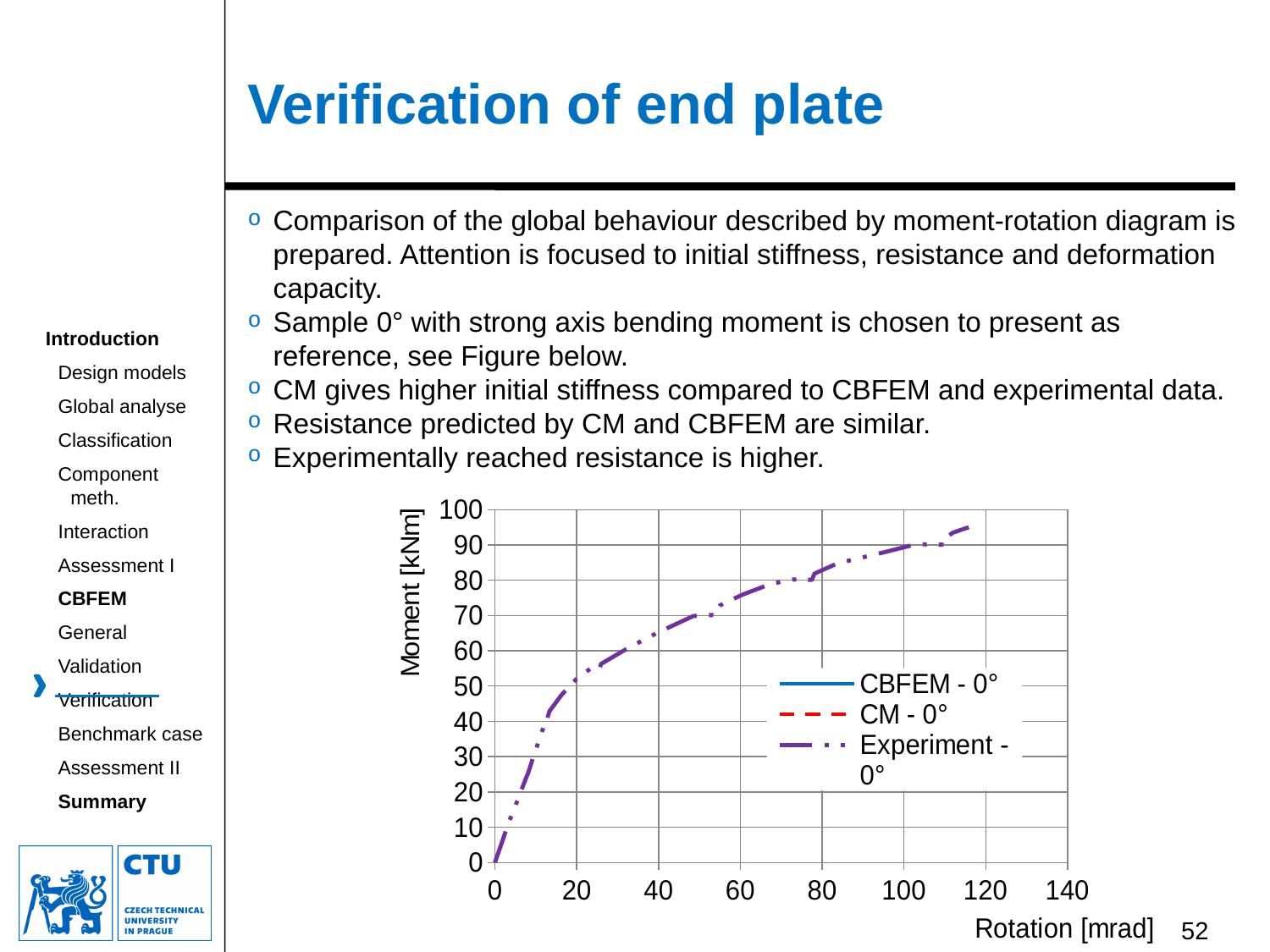
Is the moment of the Experiment - 0° curve at a rotation of 10 mrad greater or less than 50 kNm? less How many series does the chart legend list? 3 What is the label of the x axis of the chart? Rotation [mrad] What is the label of the y axis of the chart? Moment [kNm] Is the largest rotation reached by the Experiment - 0° curve greater or less than 100 mrad? greater Is the highest moment reached by the Experiment - 0° curve greater or less than 100 kNm? less Does the Experiment - 0° curve rise or fall as rotation increases? rise What kind of chart is shown on the slide? line chart What is the maximum value shown on the y axis of the chart? 100